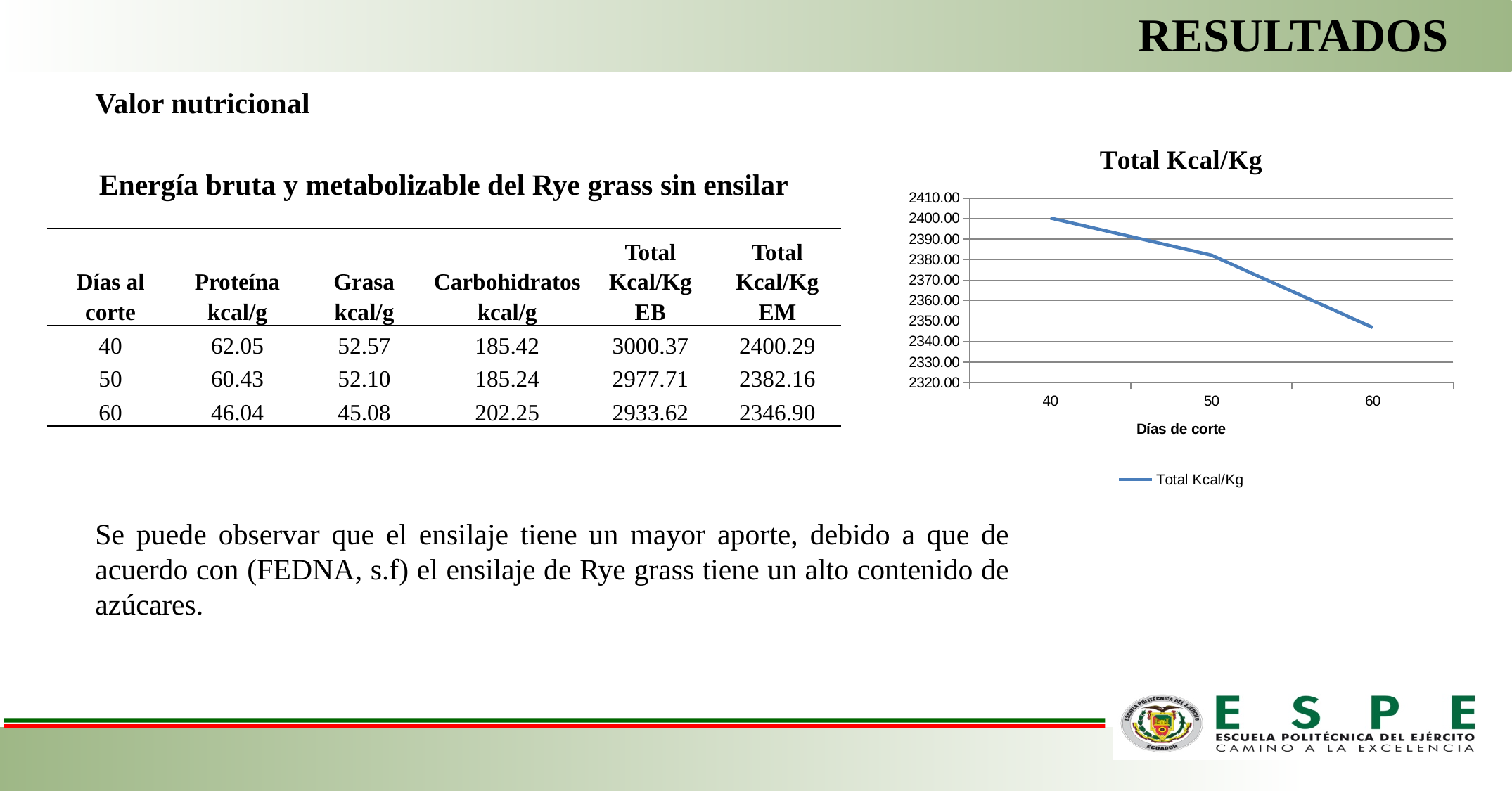
In the "Total Kcal/Kg" chart, do the values rise or fall as the days of cutting increase from 40 to 60? fall What is the name of the series shown in the legend of the line chart? Total Kcal/Kg What kind of chart is shown under the title "Total Kcal/Kg"? line chart What is the x-axis title of the "Total Kcal/Kg" chart? Días de corte In the "Total Kcal/Kg" chart, is the value for 50 days greater or less than 2390? less In the "Total Kcal/Kg" chart, which day of cutting has the highest value? 40 In the "Total Kcal/Kg" chart, which day of cutting has the lowest value? 60 In the "Total Kcal/Kg" chart, is the value for 60 days greater or less than 2360? less In the "Total Kcal/Kg" chart, how many data points are plotted along the x axis? 3 In the "Total Kcal/Kg" chart, which is larger, the value for 40 days or the value for 60 days? 40 days In the "Total Kcal/Kg" chart, is the value for 60 days greater or less than 2340? greater How many series does the legend of the "Total Kcal/Kg" chart list? 1